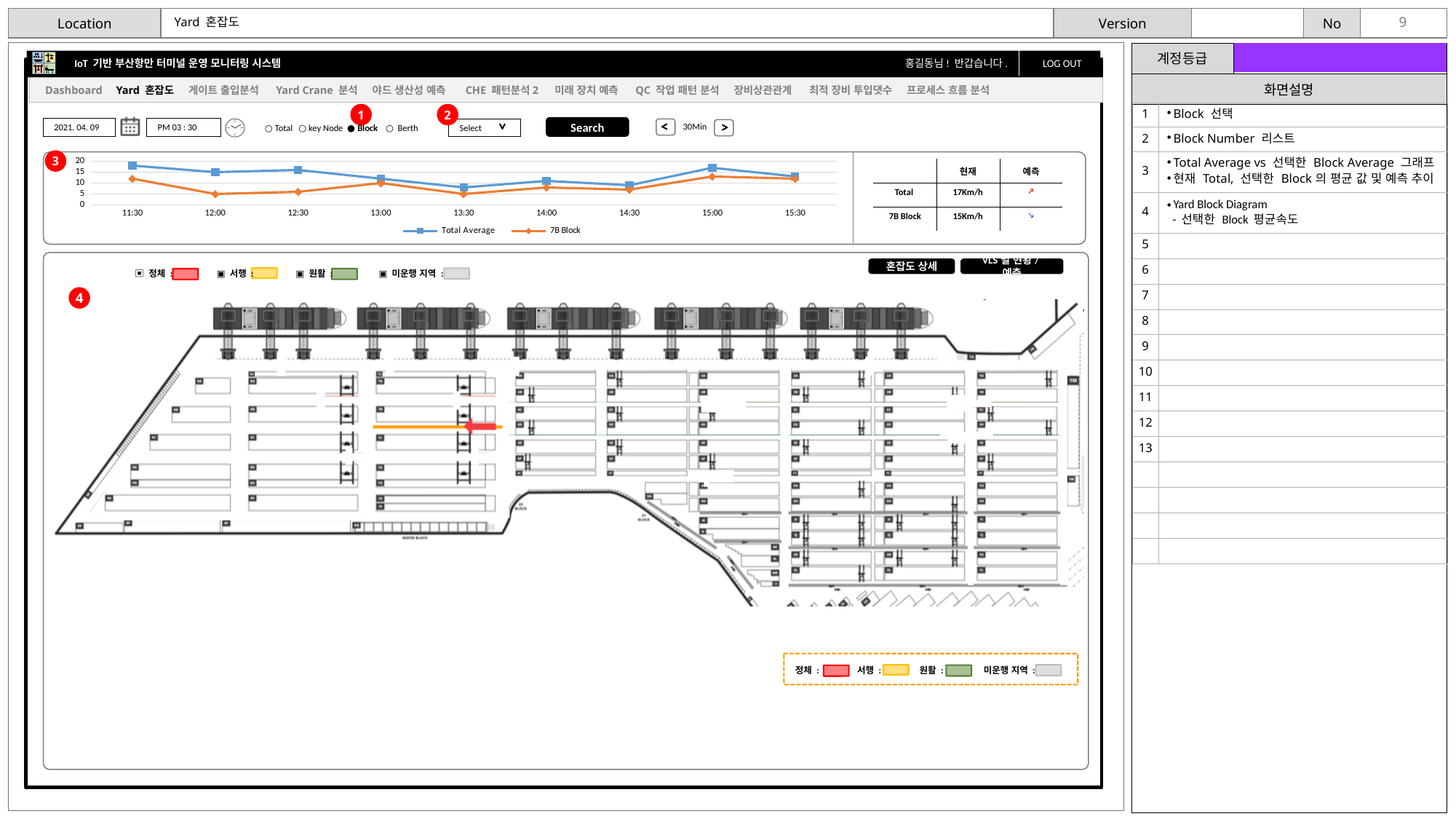
Is the value for Total Average at 11:30 greater or less than 15? greater What are the two series named in the line chart's legend? Total Average and 7B Block Does the Total Average line rise or fall between 14:30 and 15:00? rise How many series does the legend of the line chart list? 2 Does the 7B Block line rise or fall between 11:30 and 12:00? fall What kind of chart is shown at the top of the screen mock-up? line chart At 12:00, which series has the higher value in the line chart, Total Average or 7B Block? Total Average Is the value for Total Average at 13:30 greater or less than 10? less At 13:30, which series has the lower value in the line chart, Total Average or 7B Block? 7B Block How many time points are plotted along the x axis of the line chart? 9 What is the first time label on the x axis of the line chart? 11:30 Is the value for 7B Block at 12:00 greater or less than 10? less